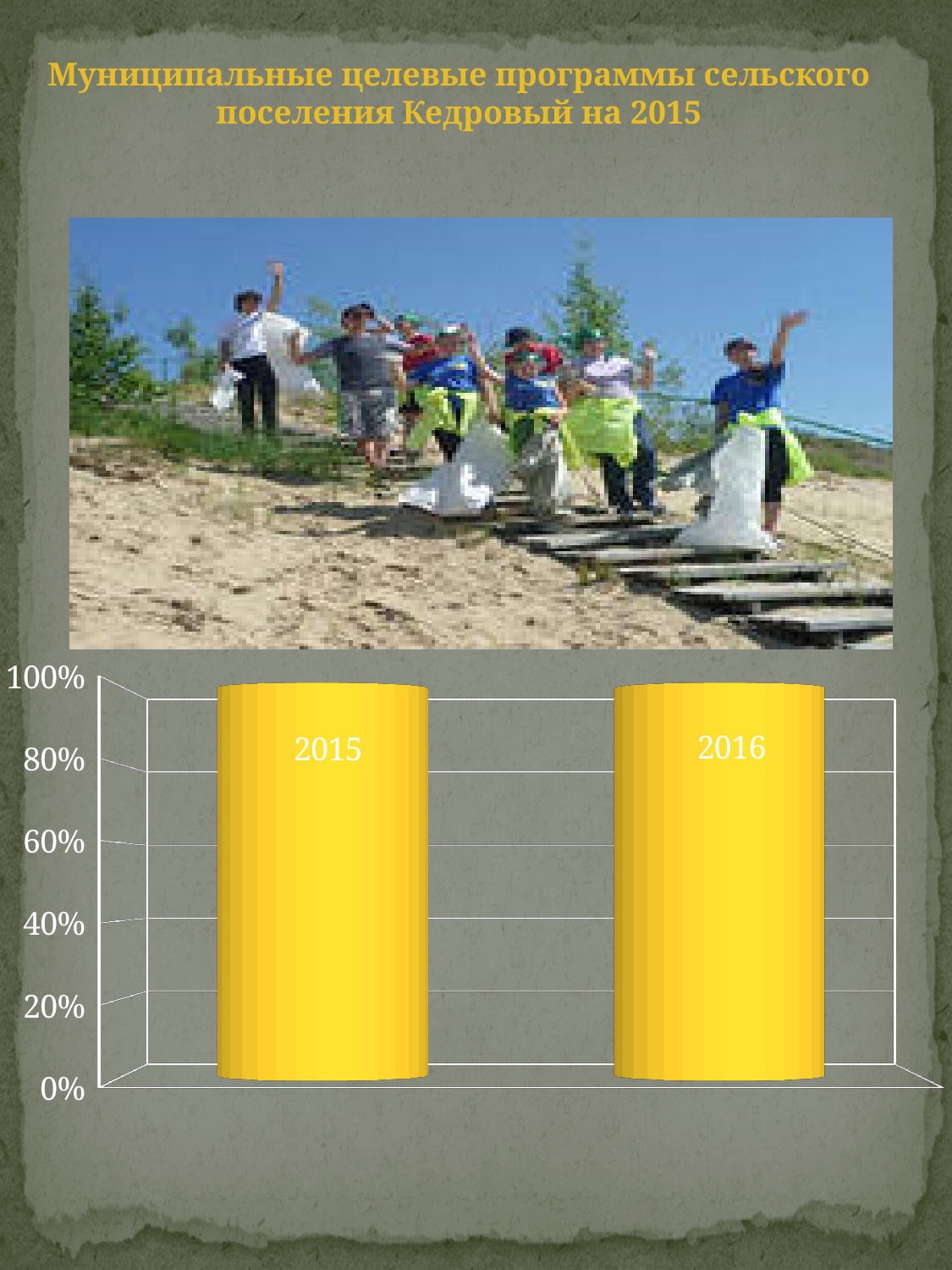
Is the value for 2016 greater or less than 60%? greater Is the value for 2016 greater or less than 80%? greater Is the value for 2015 greater or less than 80%? greater Which two years are labelled on the bars of the chart? 2015 and 2016 What kind of chart is shown on the slide? bar chart How many bars are plotted in the chart? 2 What is the highest tick shown on the vertical axis of the chart? 100% Do the values rise, fall or stay the same from 2015 to 2016? stay the same